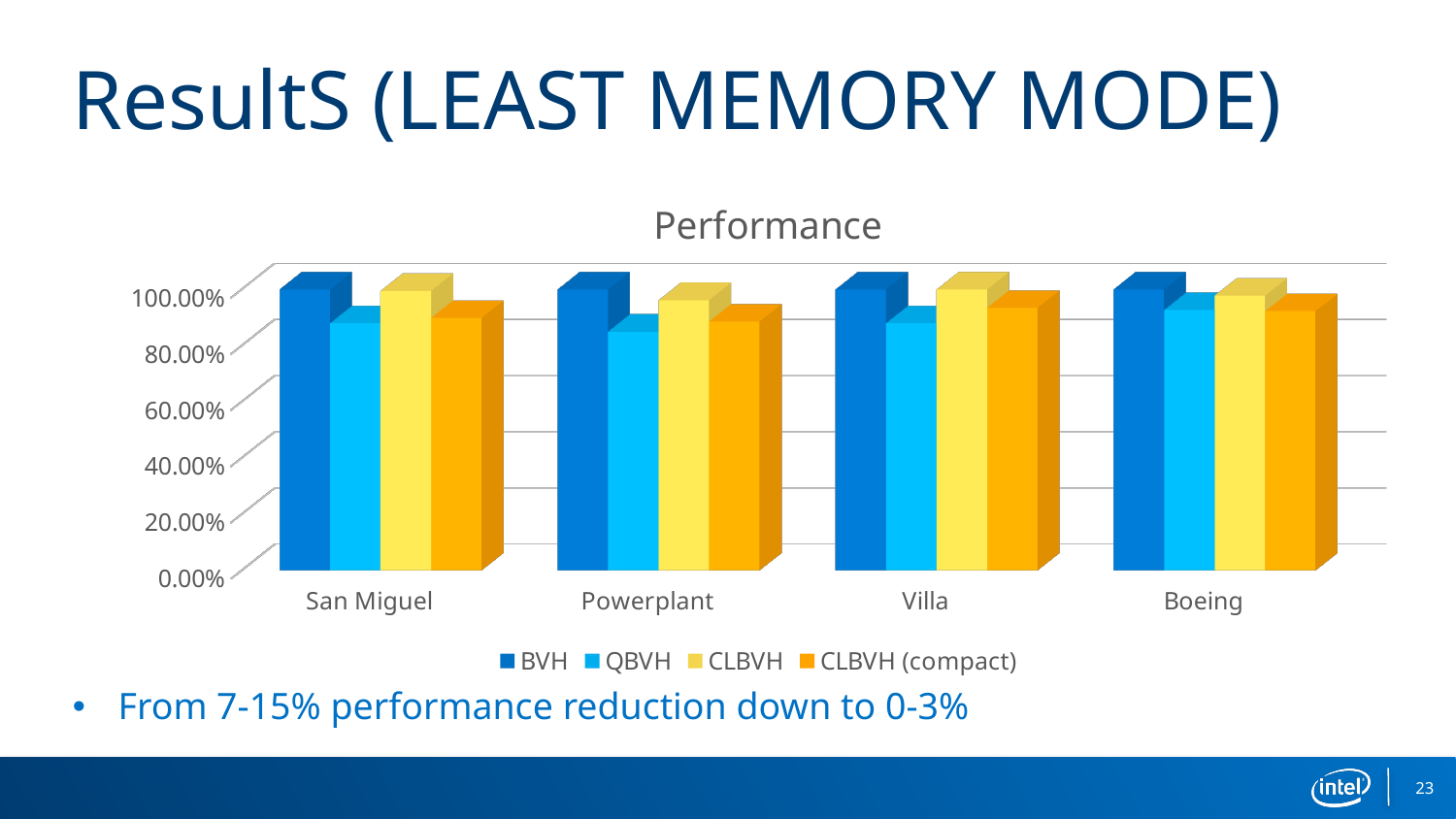
Is the CLBVH (compact) value for Boeing greater or less than 60.00%? greater Which series is listed last in the chart's legend? CLBVH (compact) For Powerplant, which series has the lowest bar? QBVH For San Miguel, which series has the lowest bar? QBVH How many categories are shown on the x axis of the chart? 4 Is the QBVH value for Powerplant greater or less than 100.00%? less What is the title of the chart? Performance How many series does the chart's legend list? 4 What kind of chart is shown on the slide? bar chart For San Miguel, which is larger: the CLBVH value or the CLBVH (compact) value? CLBVH Is the BVH value for Villa greater or less than 80.00%? greater For San Miguel, which is larger: the BVH value or the QBVH value? BVH